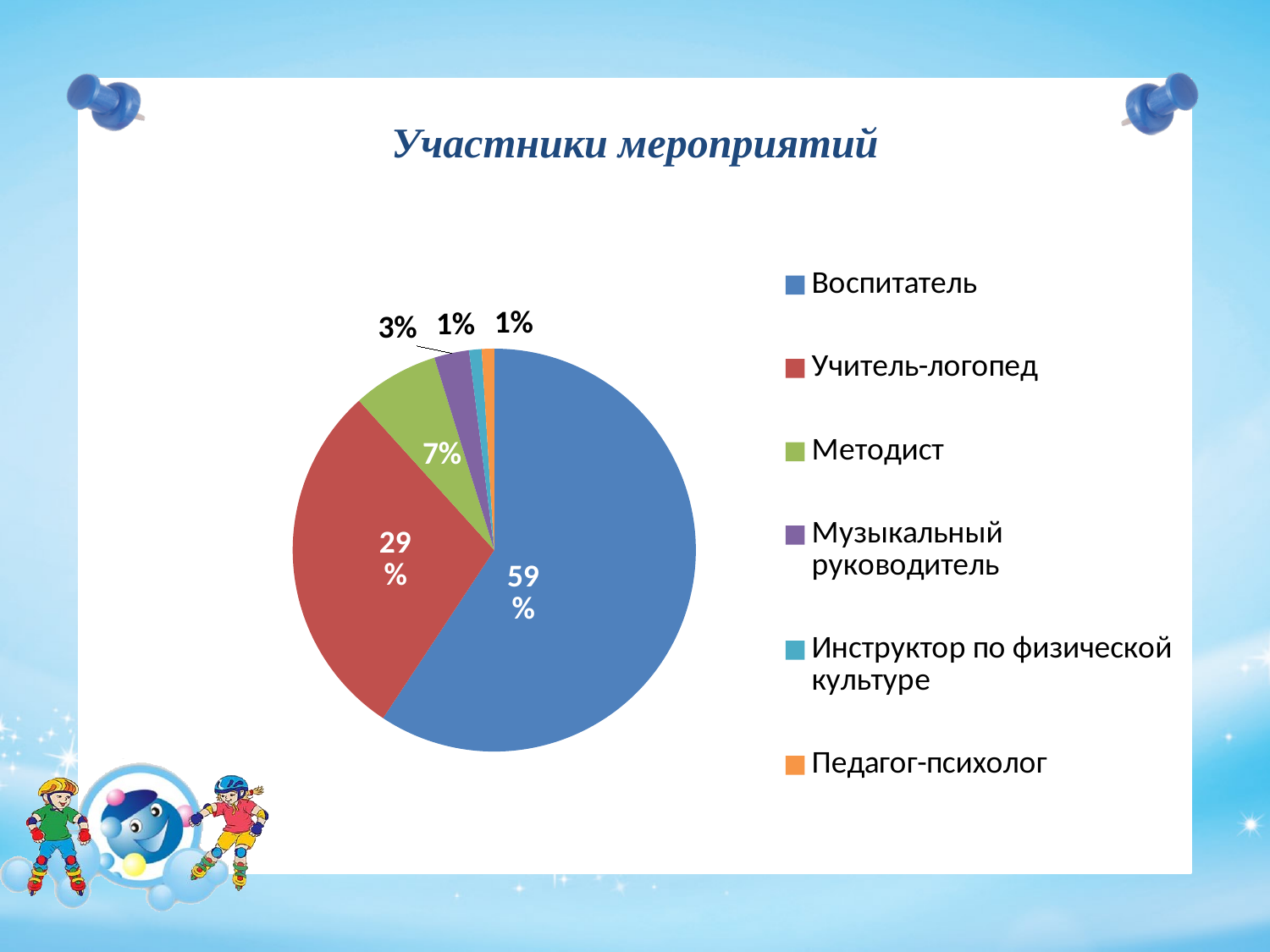
What is the value shown for Музыкальный руководитель? 3% What share of the pie does Воспитатель have? 59% What is the value shown for Методист? 7% What share of the pie does Учитель-логопед have? 29% What is the difference between the shares of Воспитатель and Учитель-логопед? 30% What is the title of the chart? Участники мероприятий What kind of chart is shown on the slide? pie chart What colour is the slice for Учитель-логопед? red Which category has the largest slice of the pie? Воспитатель What is the value shown for Педагог-психолог? 1% Which is larger, the share for Методист or the share for Музыкальный руководитель? Методист How many categories does the legend list? 6